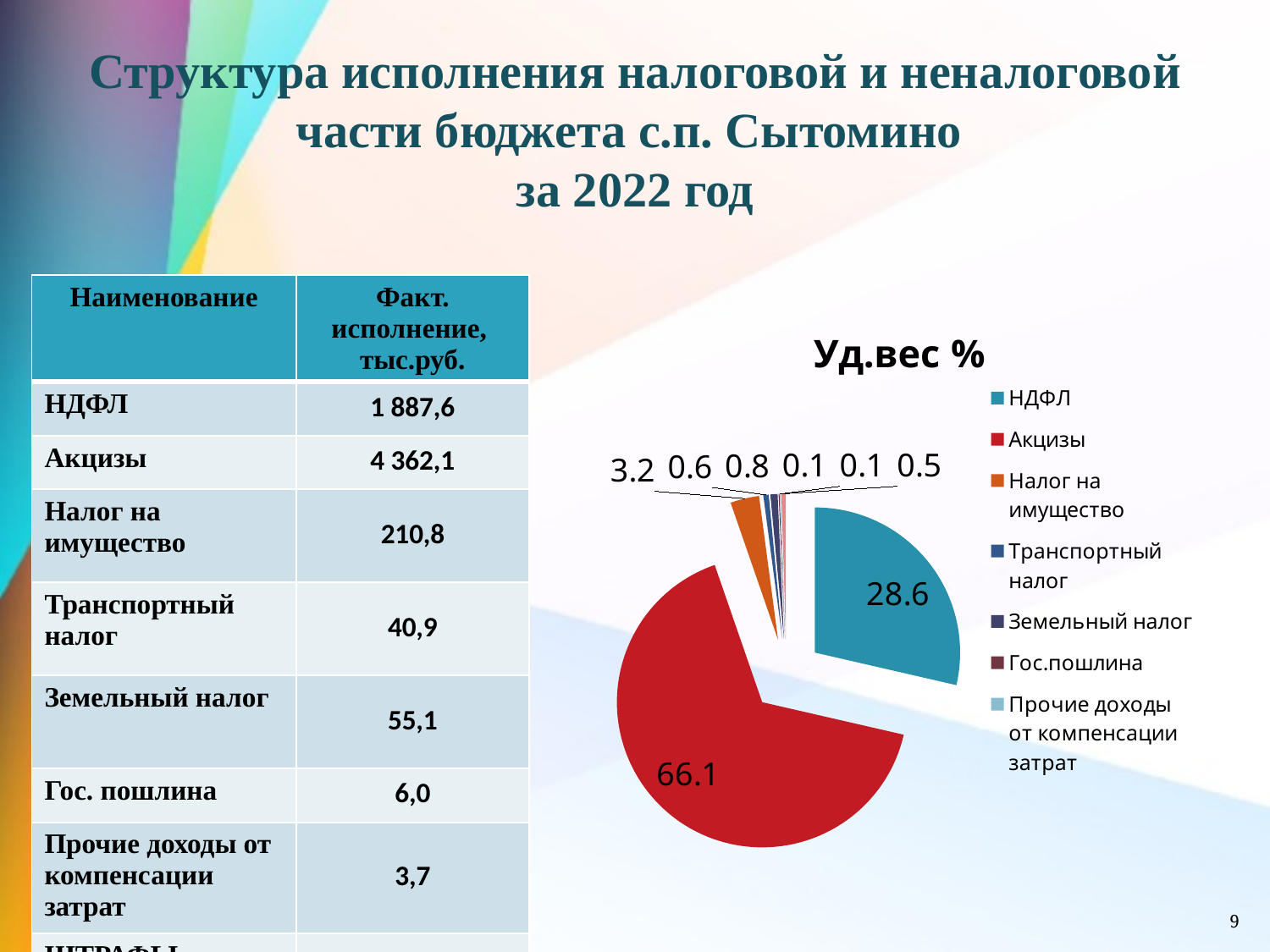
Which category has the largest slice of the pie? Акцизы What share of the pie does НДФЛ have? 28.6 What is the title of the pie chart? Уд.вес % How many entries does the pie chart legend list? 7 Which is larger in the pie chart, НДФЛ or Акцизы? Акцизы Which is larger in the pie chart, НДФЛ or Налог на имущество? НДФЛ What is the difference between the Акцизы share and the НДФЛ share in the pie chart? 37.5 What kind of chart is shown on the slide? pie chart What share of the pie does Акцизы have? 66.1 What share of the pie does Налог на имущество have? 3.2 What colour is the Акцизы slice in the pie chart? red